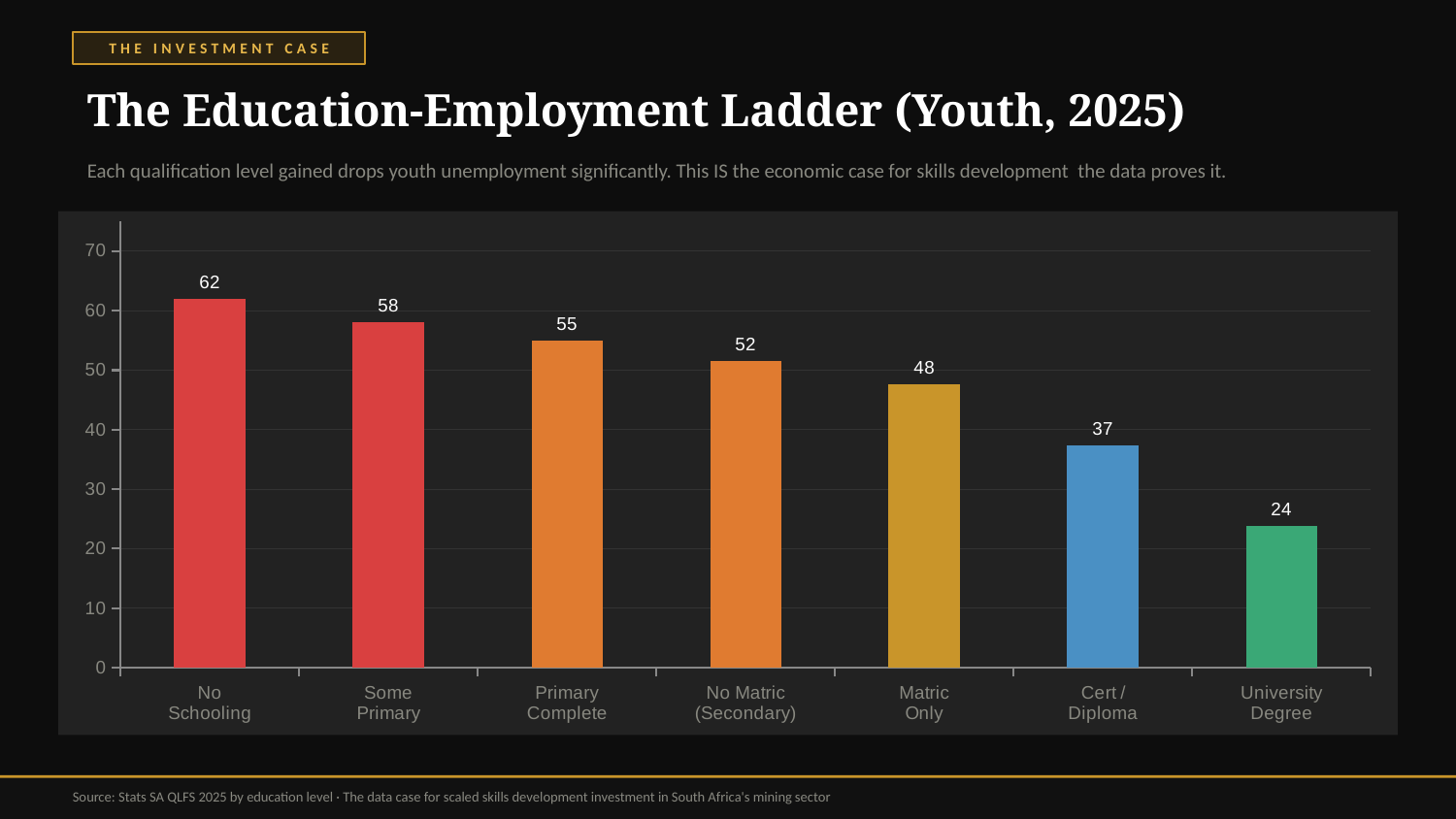
What kind of chart is shown on the slide? Bar chart What is the value for University Degree? 24 What is the difference between the values for Matric Only and Cert / Diploma? 11 Which is larger, the value for Some Primary or the value for Primary Complete? Some Primary Which category has the highest value? No Schooling How many categories are shown on the x axis? 7 What is the difference between the values for No Schooling and University Degree? 38 Do the values rise or fall moving from left to right along the x axis? Fall What is the value for No Schooling? 62 What is the value for Matric Only? 48 Which category has the lowest value? University Degree What is the value for Cert / Diploma? 37